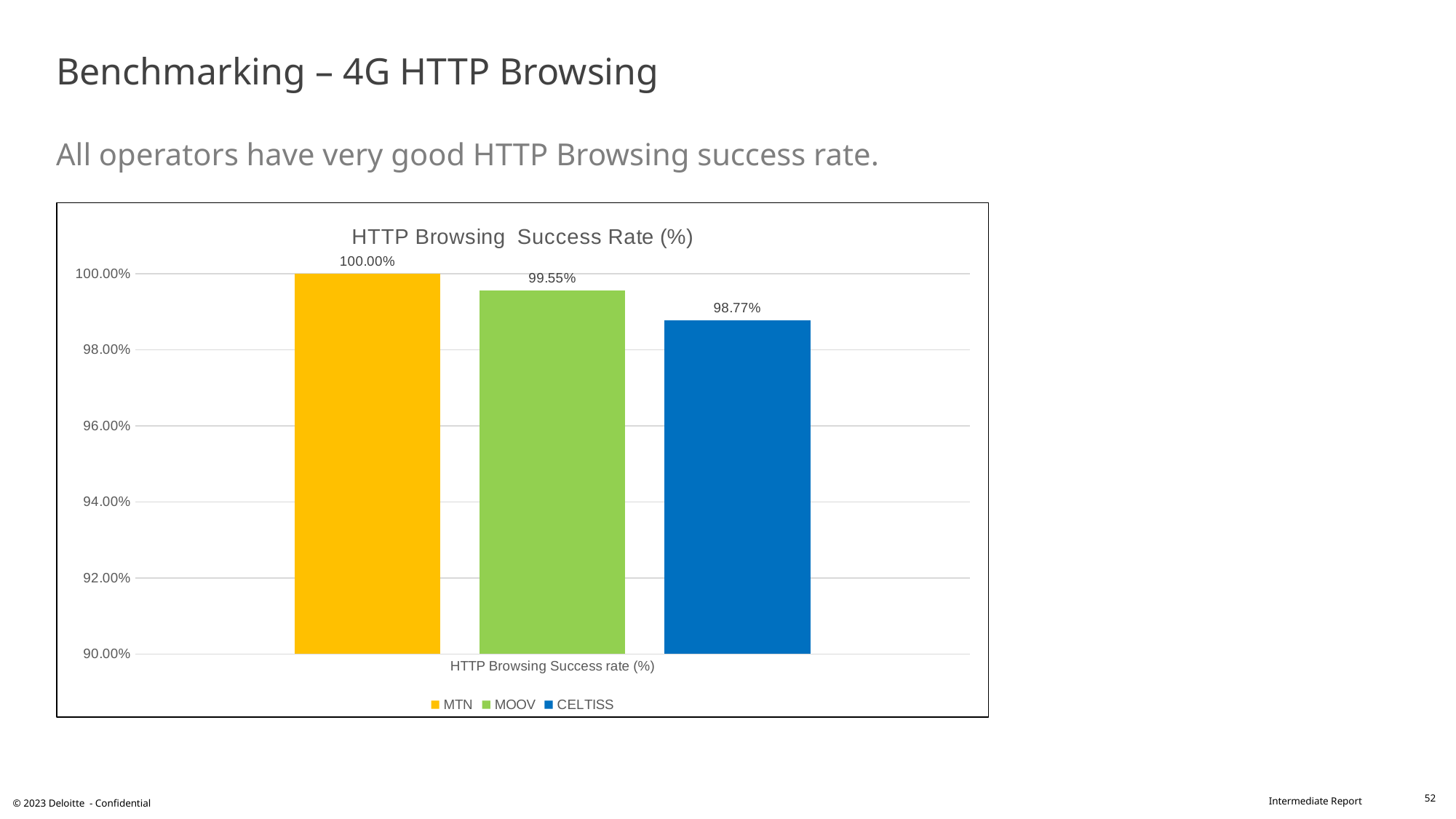
Which operator has the highest HTTP Browsing success rate? MTN How many series does the legend list? 3 What is the HTTP Browsing success rate for CELTISS? 98.77% What is the HTTP Browsing success rate for MTN? 100.00% What is the title of the chart? HTTP Browsing Success Rate (%) What is the difference between the HTTP Browsing success rates of MTN and CELTISS? 1.23% Is the HTTP Browsing success rate for CELTISS greater or less than 98.00%? greater What is the difference between the HTTP Browsing success rates of MOOV and CELTISS? 0.78% Which has a higher HTTP Browsing success rate, MOOV or CELTISS? MOOV What kind of chart is shown on the slide? Bar chart Which operator has the lowest HTTP Browsing success rate? CELTISS What is the HTTP Browsing success rate for MOOV? 99.55%